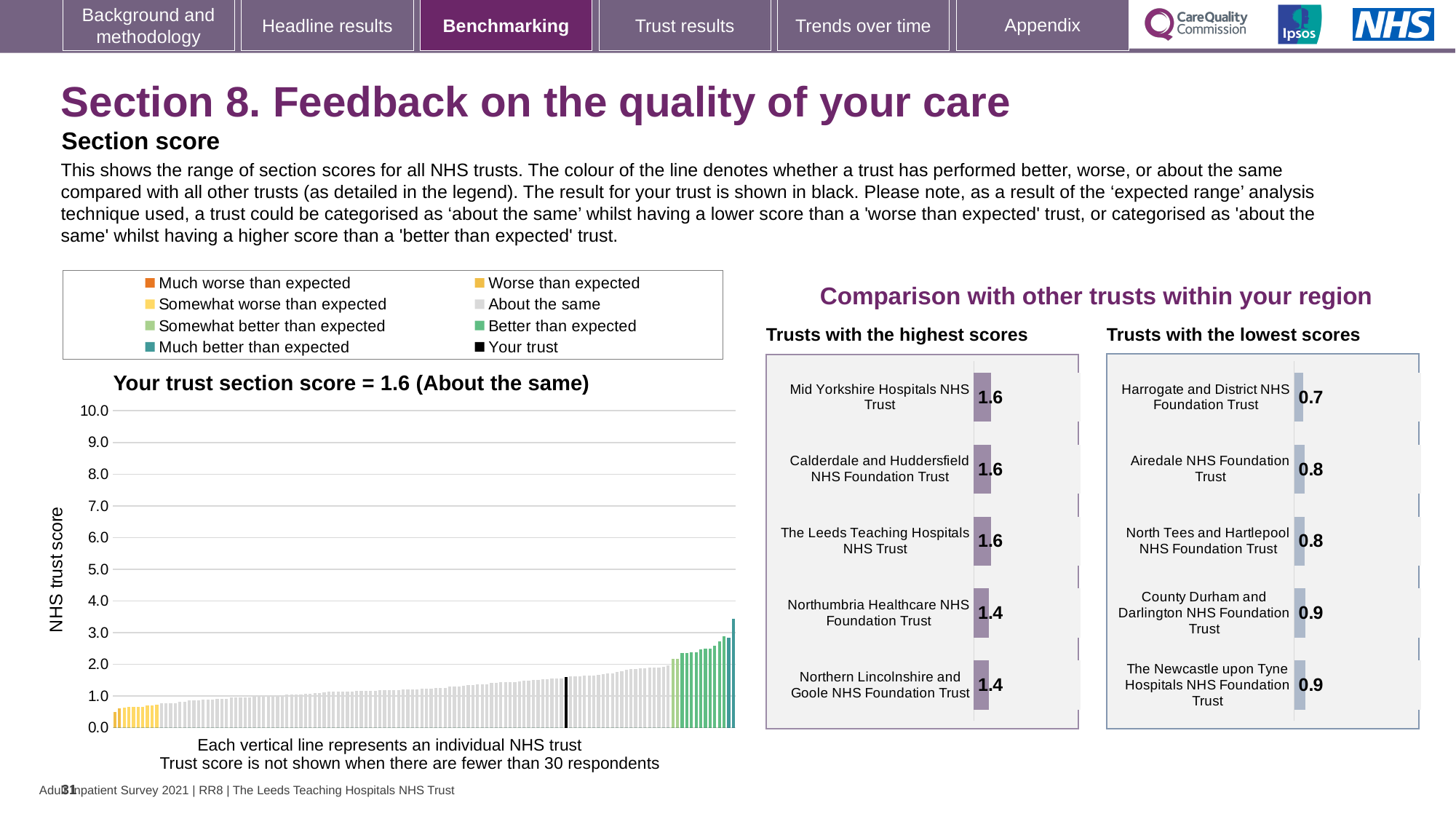
In the 'Trusts with the lowest scores' chart, which trust has the lowest score? Harrogate and District NHS Foundation Trust In the 'Trusts with the highest scores' chart, how many trusts are listed? 5 In the 'Trusts with the lowest scores' chart, which has the larger score: Airedale NHS Foundation Trust or County Durham and Darlington NHS Foundation Trust? County Durham and Darlington NHS Foundation Trust In the 'Trusts with the highest scores' chart, what is the difference between the scores of Mid Yorkshire Hospitals NHS Trust and Northern Lincolnshire and Goole NHS Foundation Trust? 0.2 In the 'Your trust section score' chart, is the highest trust score greater or less than 3.0? greater In the 'Trusts with the highest scores' chart, what is the score for Northumbria Healthcare NHS Foundation Trust? 1.4 In the 'Your trust section score' chart, what kind of chart is shown? bar chart In the 'Your trust section score' chart, do the trust scores rise or fall from left to right? rise How many entries does the legend above the 'Your trust section score' chart list? 8 In the 'Trusts with the lowest scores' chart, what is the score for The Newcastle upon Tyne Hospitals NHS Foundation Trust? 0.9 In the 'Your trust section score' chart, what is the section score for your trust? 1.6 In the 'Your trust section score' chart, is the value for your trust (the black line) greater or less than 2.0? less